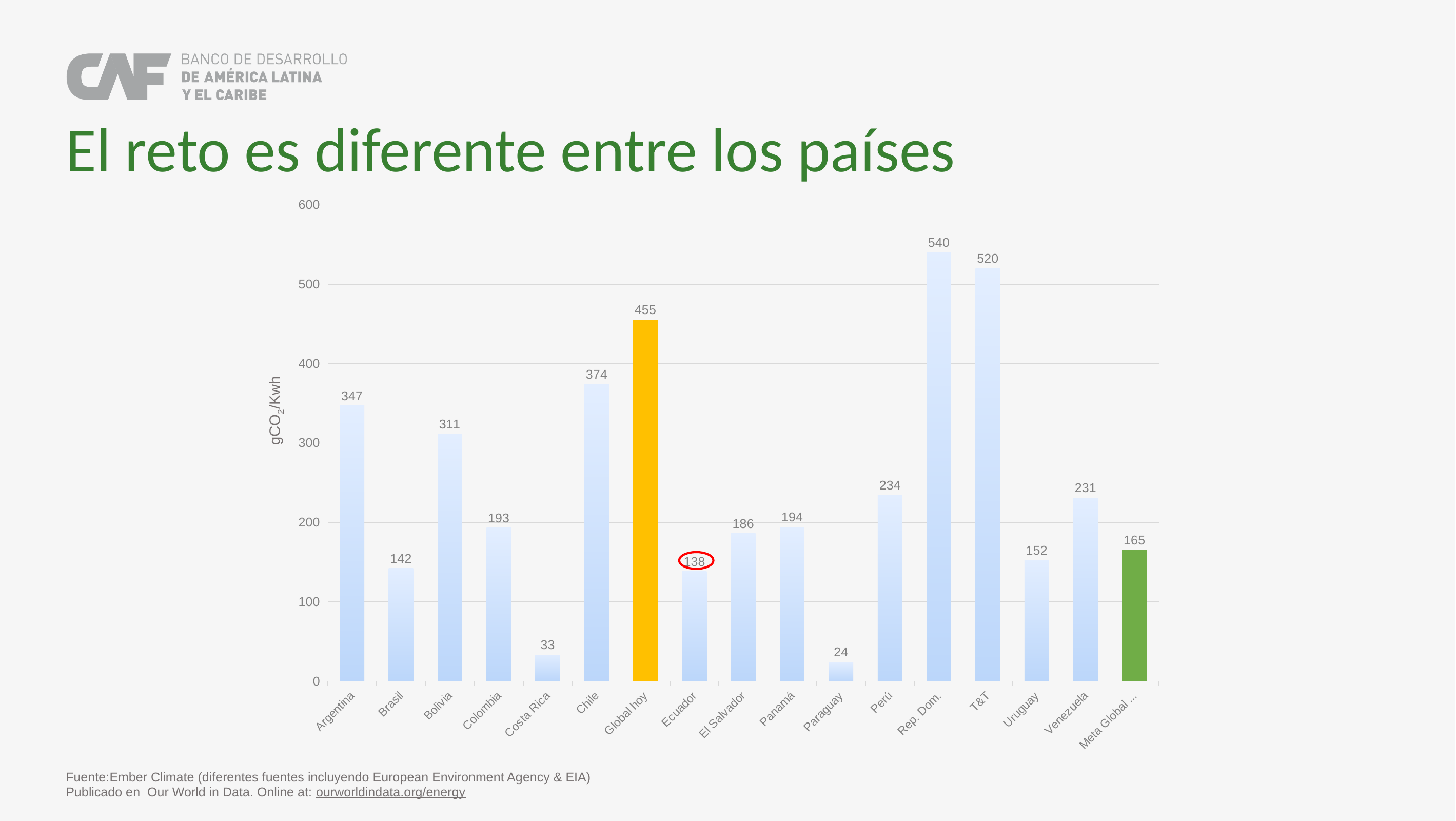
What is the value for Global hoy? 455 Which category has the lowest value? Paraguay Which bar is coloured green? Meta Global ... How many bars are shown in the chart? 17 What is the value for Ecuador? 138 Is the value for Perú greater or less than 200? greater What is the label on the vertical axis? gCO2/Kwh Which is larger, the value for Chile or the value for Bolivia? Chile What is the value for Argentina? 347 What is the difference between the values for Rep. Dom. and T&T? 20 Which category has the highest value? Rep. Dom. What kind of chart is shown on the slide? Bar chart